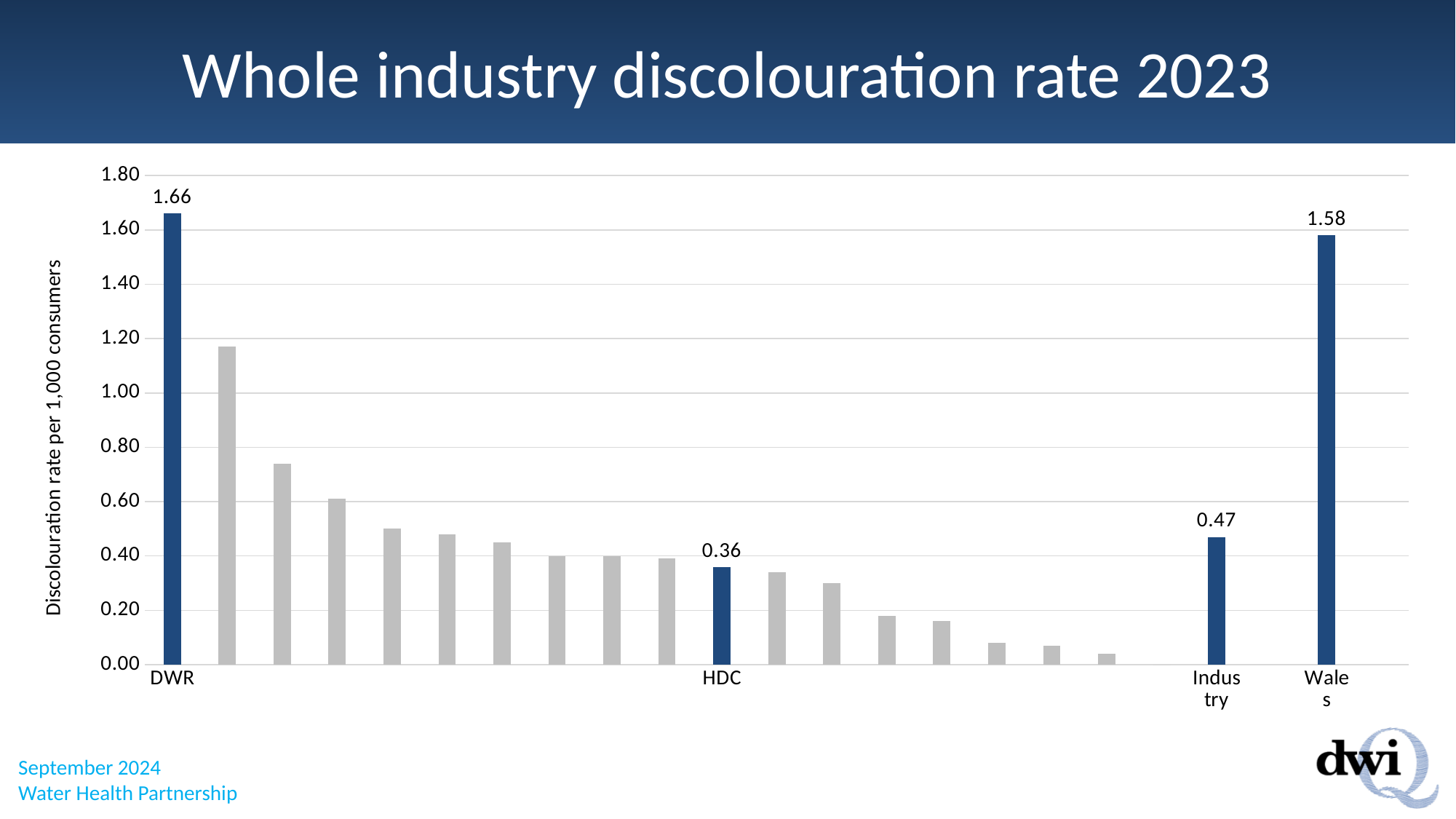
Which has a higher discolouration rate, HDC or Industry? Industry What is the discolouration rate for Industry? 0.47 What kind of chart is shown on the slide? bar chart Which labelled category has the lowest discolouration rate? HDC Is the value for Wales greater or less than 1.60? less What is the difference between the discolouration rates for Industry and HDC? 0.11 Which labelled category has the highest discolouration rate? DWR What is the title of the vertical axis? Discolouration rate per 1,000 consumers What is the discolouration rate for Wales? 1.58 What is the discolouration rate for DWR? 1.66 What is the discolouration rate for HDC? 0.36 What is the difference between the discolouration rates for DWR and Wales? 0.08